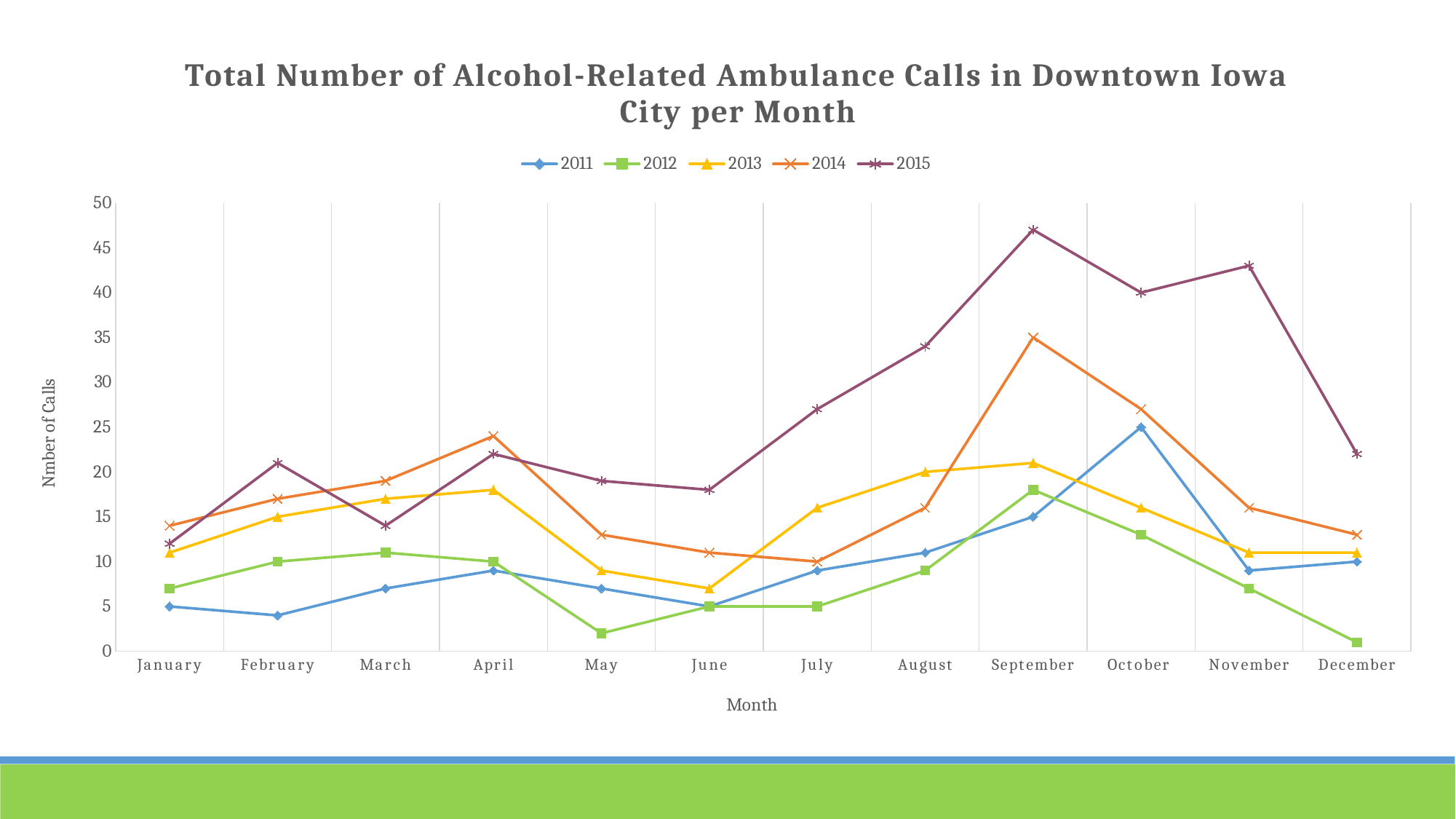
What is the value for 2011 in October? 25 What kind of chart is shown on the slide? line chart Is the value for 2012 in December greater or less than 5? less Is the value for 2015 in September greater or less than 45? greater In which month does the 2012 series reach its lowest value? December Does the 2015 series rise or fall from June to September? rise In which month does the 2015 series reach its highest value? September How many series does the legend list? 5 What is the value for 2014 in September? 35 How many months are plotted along the x axis? 12 What is the value for 2015 in October? 40 In November, which series has the larger value, 2014 or 2015? 2015